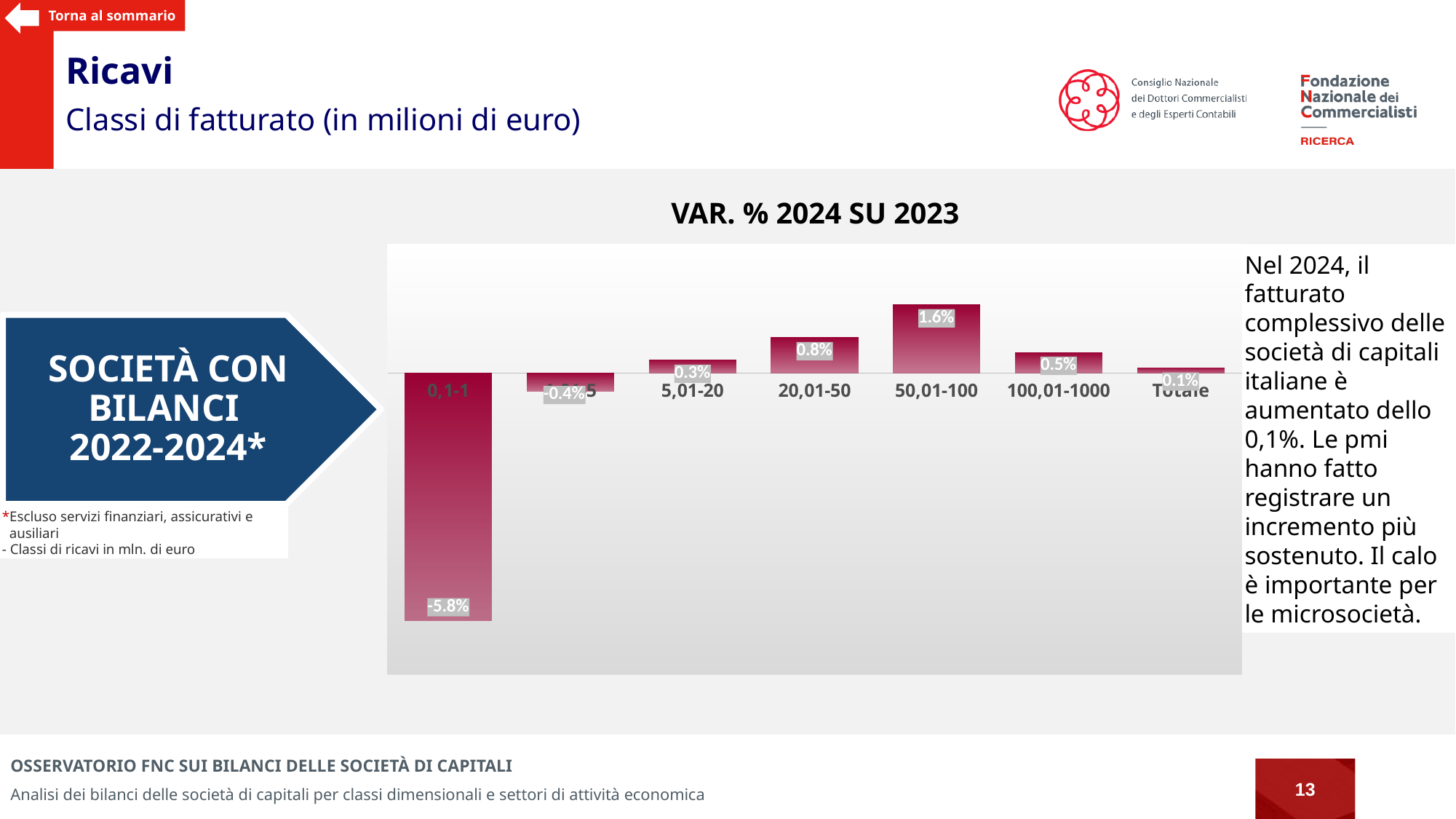
What kind of chart is shown on the slide? bar chart What is the value for the 100,01-1000 class? 0.5% Which category has the lowest value? 0,1-1 What is the value for the 20,01-50 class? 0.8% What is the value for Totale? 0.1% What is the value for the 0,1-1 class? -5.8% Which category has the highest value? 50,01-100 How many categories are plotted in the chart? 7 Which is larger, the value for 5,01-20 or the value for 100,01-1000? 100,01-1000 What is the value for the 50,01-100 class? 1.6% What is the difference between the values for 50,01-100 and 20,01-50? 0.8% What is the title of the chart? VAR. % 2024 SU 2023